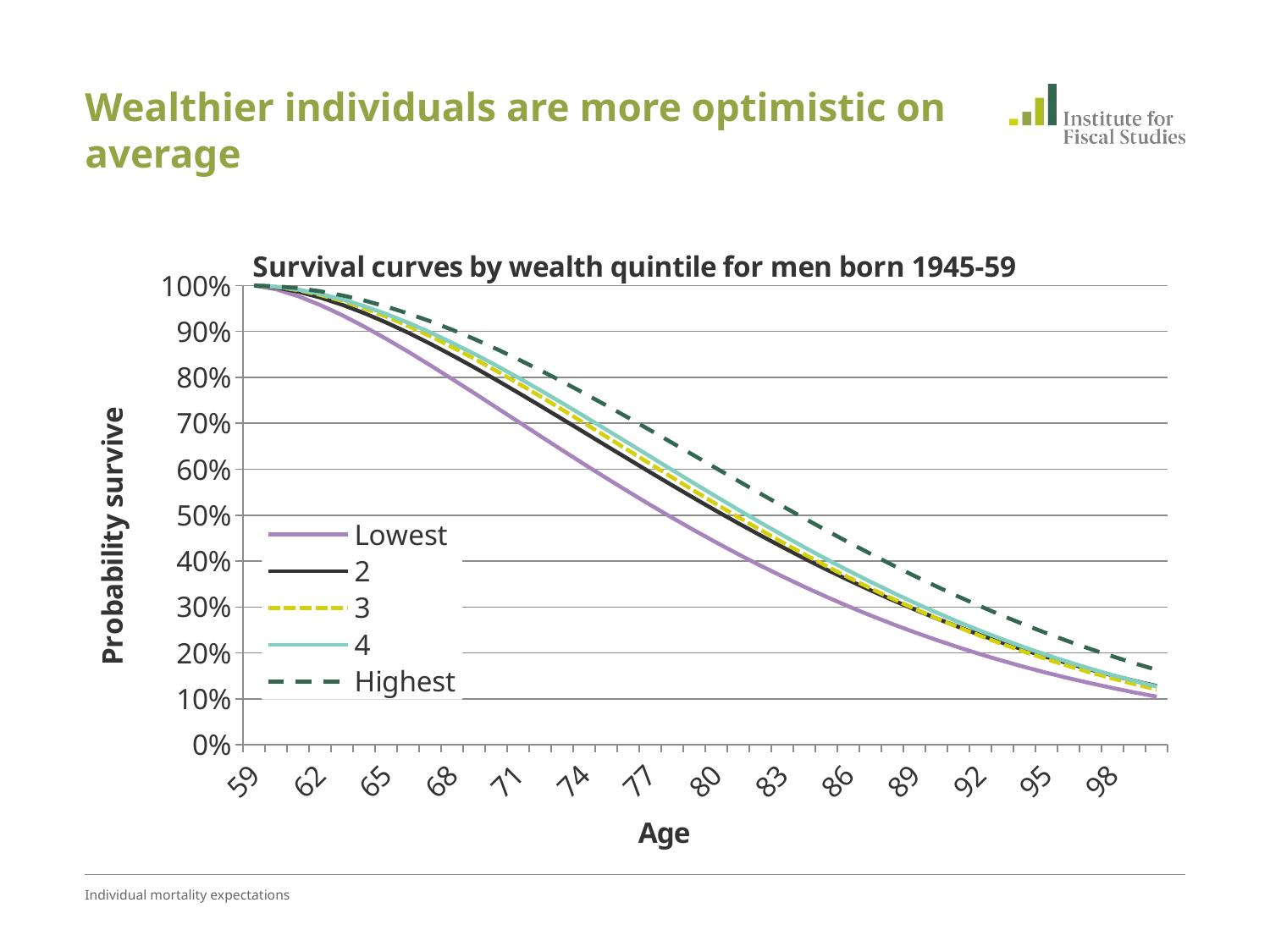
Which wealth quintile has the lowest probability of survival at age 80? Lowest How many series does the legend list? 5 What kind of chart is shown on the slide? Line chart Is the survival probability for the Highest quintile at age 71 greater or less than 80%? greater At age 86, which is larger: the survival probability for the Highest quintile or for quintile 2? Highest Do the survival curves rise or fall as age increases? Fall What is the title of the chart? Survival curves by wealth quintile for men born 1945-59 Which wealth quintile has the highest probability of survival at age 80? Highest Is the survival probability for the Lowest quintile at age 98 greater or less than 20%? less What is the label of the vertical axis? Probability survive What is the probability of survival at age 59 for the Lowest wealth quintile? 100% Is the survival probability for the Lowest quintile at age 80 greater or less than 50%? less